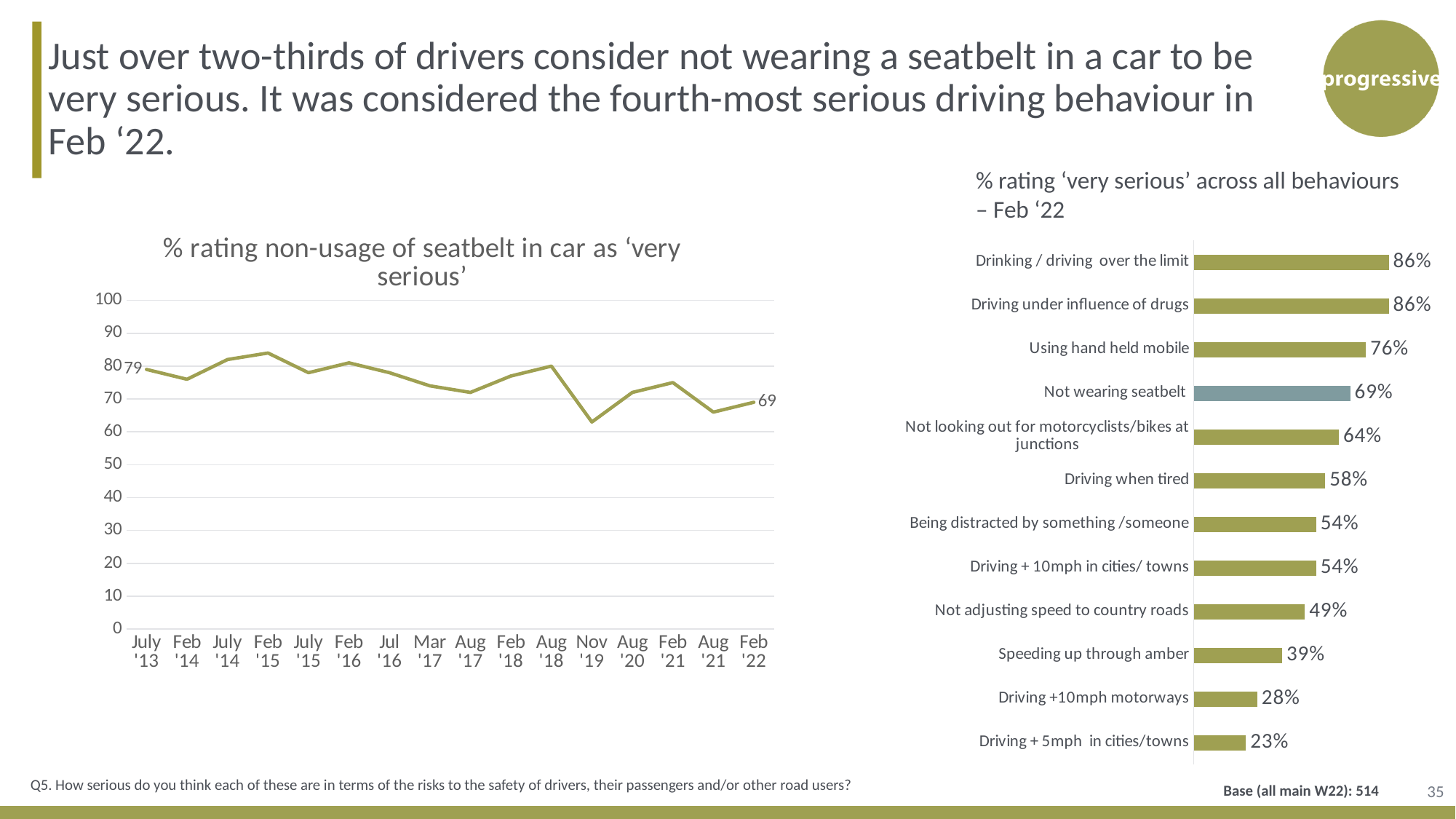
In the line chart on the left, is the value for Nov '19 greater or less than 70? less In the line chart on the left, is the value for Feb '15 greater or less than 80? greater How many time points are plotted in the line chart on the left? 16 In the chart titled '% rating non-usage of seatbelt in car as ‘very serious’', what is the value for Feb '22? 69 In the bar chart on the right, which is larger: 'Using hand held mobile' or 'Driving when tired'? Using hand held mobile In the bar chart on the right, what is the value for 'Not wearing seatbelt'? 69% In the bar chart on the right, what is the difference between 'Drinking / driving over the limit' and 'Not wearing seatbelt'? 17 percentage points In the bar chart on the right, what is the value for 'Speeding up through amber'? 39% What kind of chart is the chart on the right titled '% rating ‘very serious’ across all behaviours – Feb ‘22'? bar chart In the line chart on the left, does the value overall rise or fall from July '13 to Feb '22? fall In the chart titled '% rating non-usage of seatbelt in car as ‘very serious’', what is the value for July '13? 79 In the bar chart on the right, which behaviour has the lowest value? Driving + 5mph in cities/towns